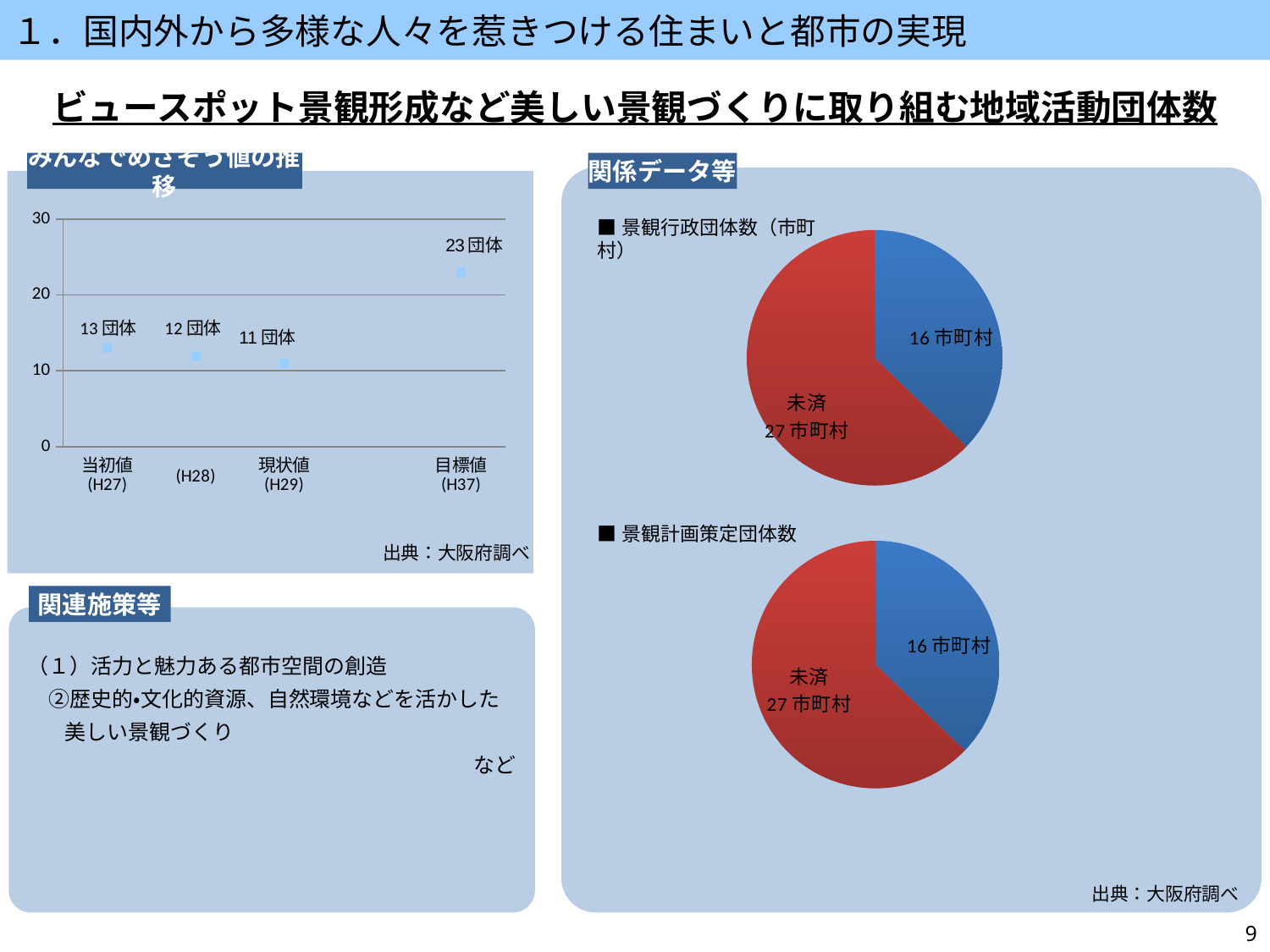
In the chart titled みんなでめざそう値の推移, what is the value for 現状値 (H29)? 11 団体 In the chart titled みんなでめざそう値の推移, what is the difference between the 目標値 (H37) value and the 現状値 (H29) value? 12 団体 In the chart titled みんなでめざそう値の推移, what is the value for 当初値 (H27)? 13 団体 In the chart titled みんなでめざそう値の推移, how many data points are plotted? 4 In the chart titled みんなでめざそう値の推移, which category has the highest value? 目標値 (H37) In the pie chart titled 景観行政団体数（市町村）, which slice is larger, the blue slice or the 未済 slice? 未済 What kind of chart is the chart titled 景観計画策定団体数? pie chart In the chart titled みんなでめざそう値の推移, what is the value for 目標値 (H37)? 23 団体 In the chart titled みんなでめざそう値の推移, which category has the lowest value? 現状値 (H29) In the chart titled みんなでめざそう値の推移, do the values rise or fall from 当初値 (H27) to 現状値 (H29)? fall In the pie chart titled 景観行政団体数（市町村）, what is the value of the 未済 slice? 27 市町村 In the pie chart titled 景観計画策定団体数, what is the value of the blue slice? 16 市町村